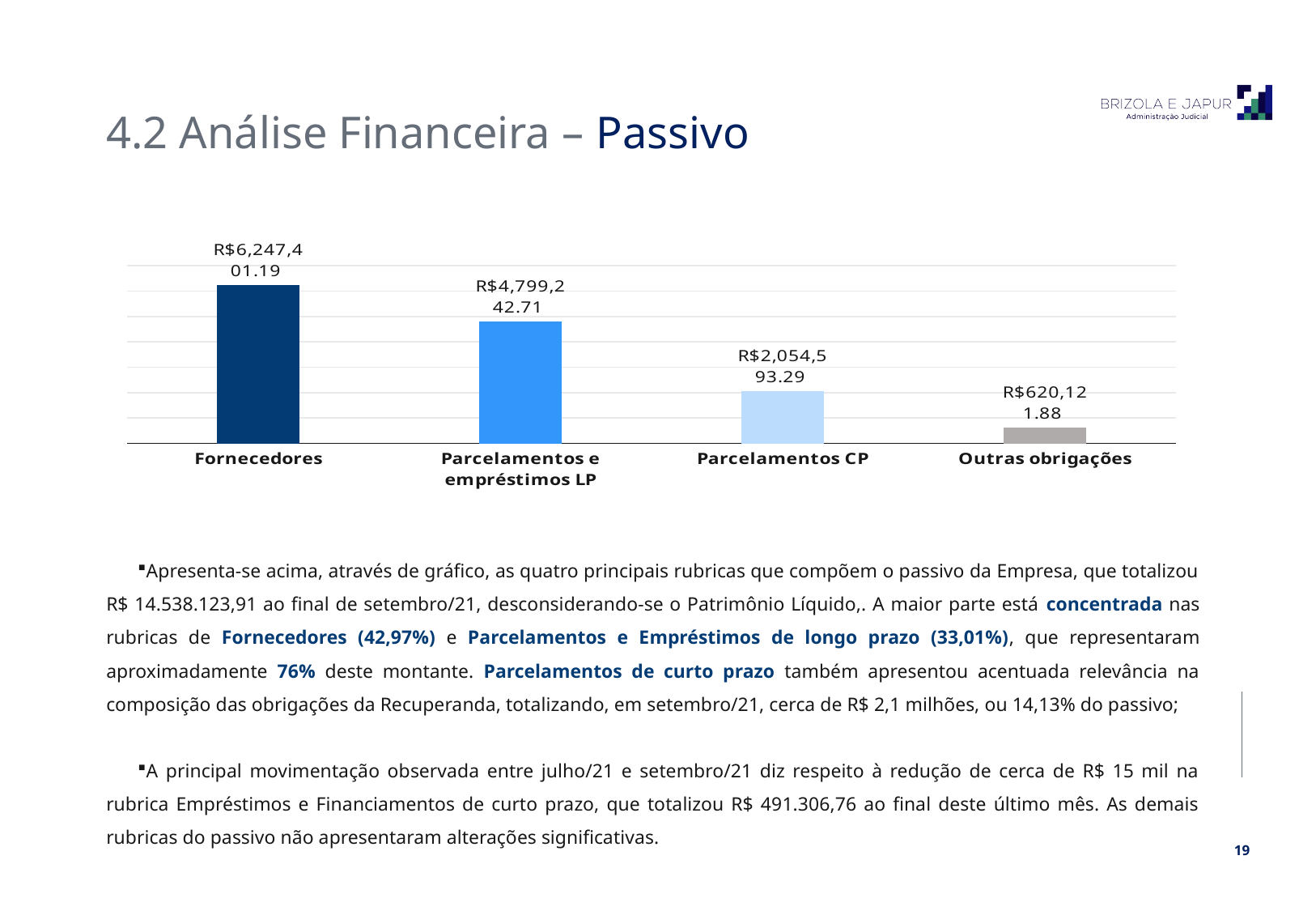
What is the value shown for Fornecedores? R$6,247,401.19 Which is larger, the value for Parcelamentos CP or the value for Outras obrigações? Parcelamentos CP What is the difference between the values for Fornecedores and Parcelamentos e empréstimos LP? R$1,448,158.48 Do the values rise or fall from left to right across the categories? Fall What kind of chart is shown on the slide? Bar chart What is the value shown for Parcelamentos e empréstimos LP? R$4,799,242.71 What is the difference between the values for Parcelamentos CP and Outras obrigações? R$1,434,471.41 What is the value shown for Parcelamentos CP? R$2,054,593.29 What is the value shown for Outras obrigações? R$620,121.88 Which category has the lowest value in the chart? Outras obrigações How many categories are shown in the chart? 4 Which category has the highest value in the chart? Fornecedores